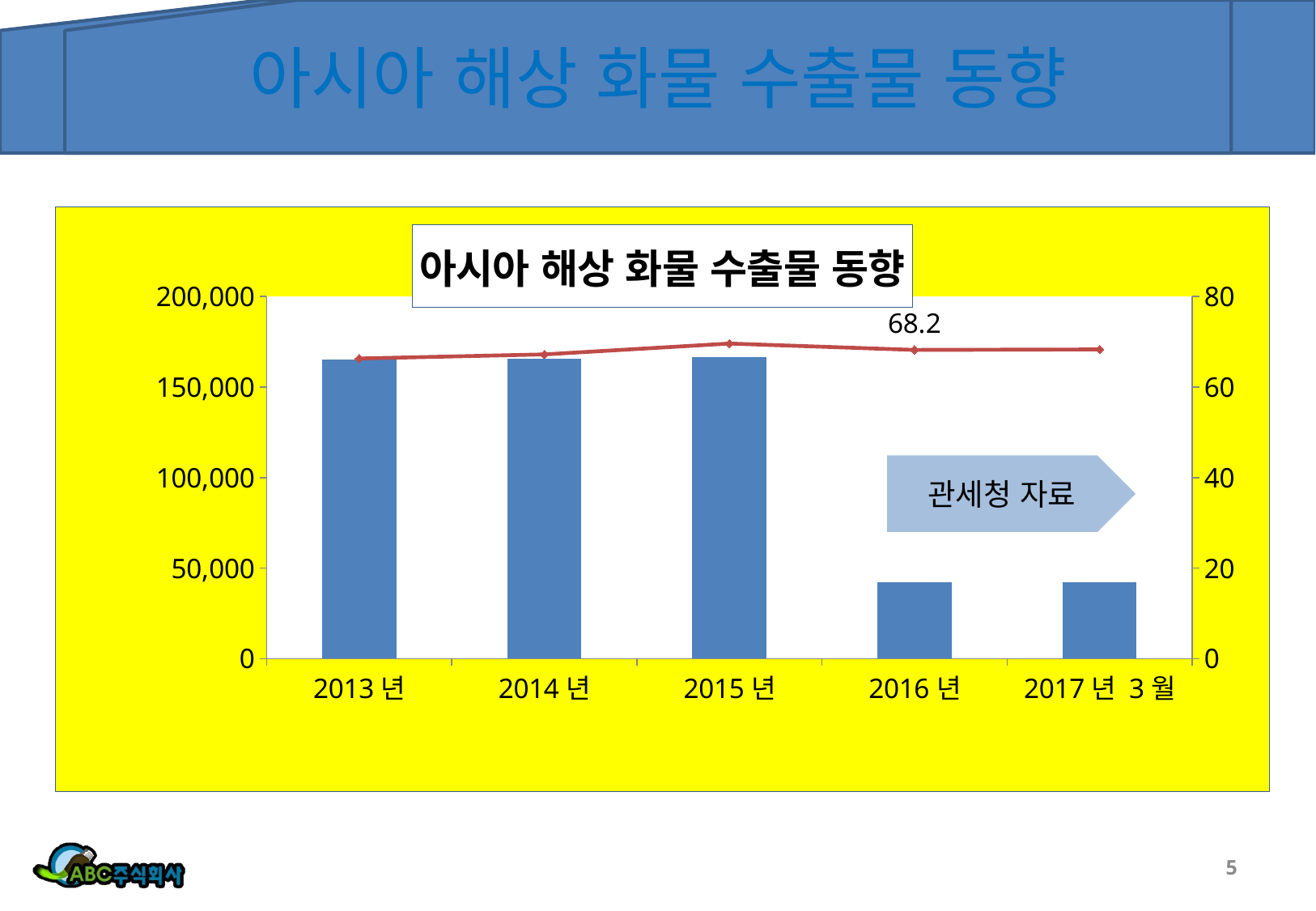
Is the bar value for 2016 년 greater or less than 50,000? less Which has the larger bar, 2015 년 or 2016 년? 2015 년 Is the bar value for 2013 년 greater or less than 150,000? greater Do the bar values rise or fall from 2015 년 to 2016 년? fall What kind of chart is shown on the slide? bar chart with a line Which has the larger bar, 2014 년 or 2017 년 3 월? 2014 년 How many categories are shown on the x axis of the chart? 5 Is the bar value for 2017 년 3 월 greater or less than 100,000? less What is the highest tick value shown on the right-hand axis? 80 What value is labelled on the line for 2016 년? 68.2 What is the title of the chart? 아시아 해상 화물 수출물 동향